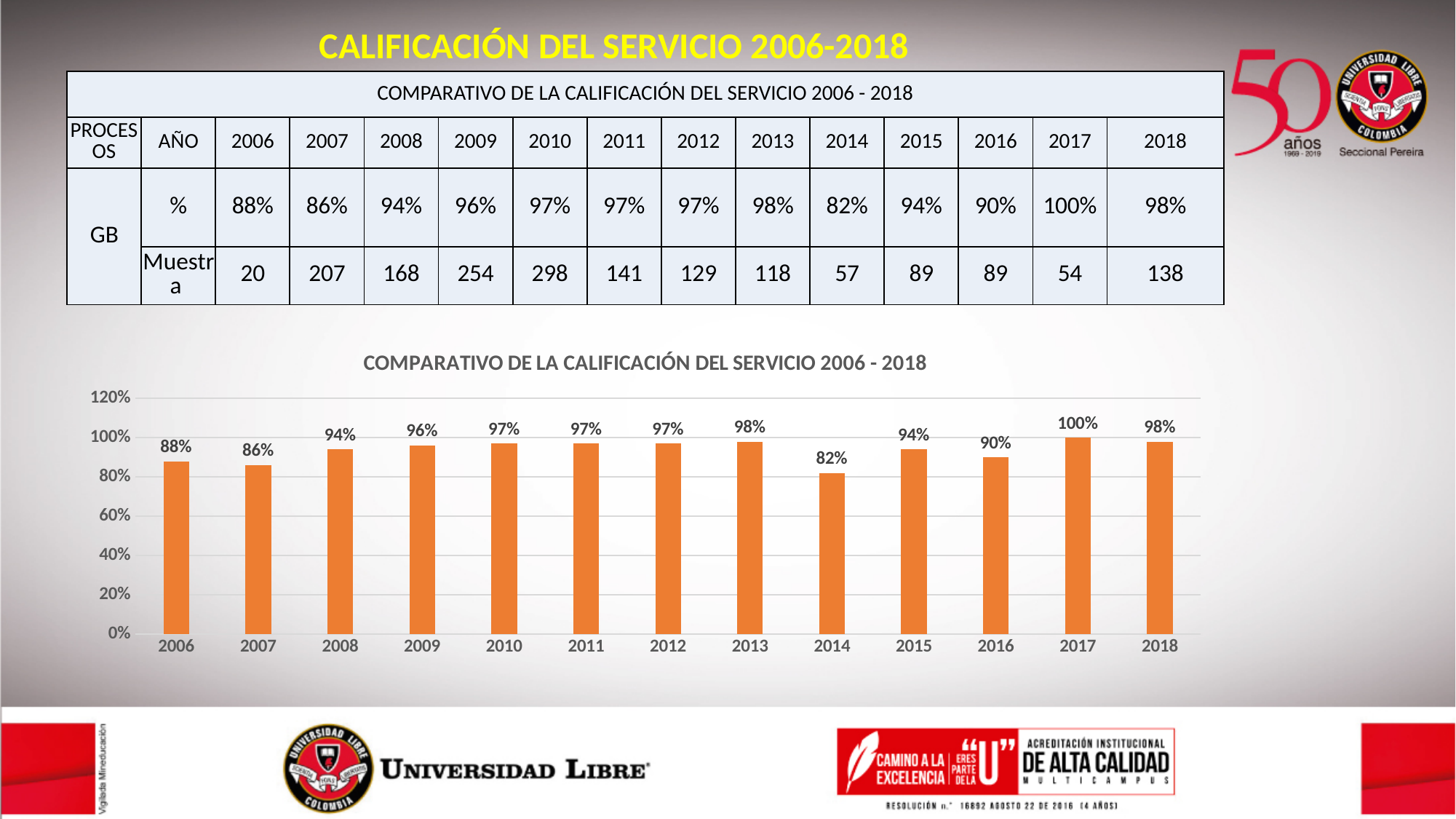
What is the difference between the values for 2017 and 2014? 18% How many years are shown on the x axis of the chart? 13 What colour are the bars in the chart? orange Which is larger, the value for 2006 or the value for 2007? 2006 What kind of chart is shown on the slide? bar chart What is the value for 2014 in the chart? 82% What is the value for 2009 in the chart? 96% What is the title of the chart? COMPARATIVO DE LA CALIFICACIÓN DEL SERVICIO 2006 - 2018 Which year has the lowest value in the chart? 2014 Which year has the highest value in the chart? 2017 Is the value for 2016 greater or less than 80%? greater